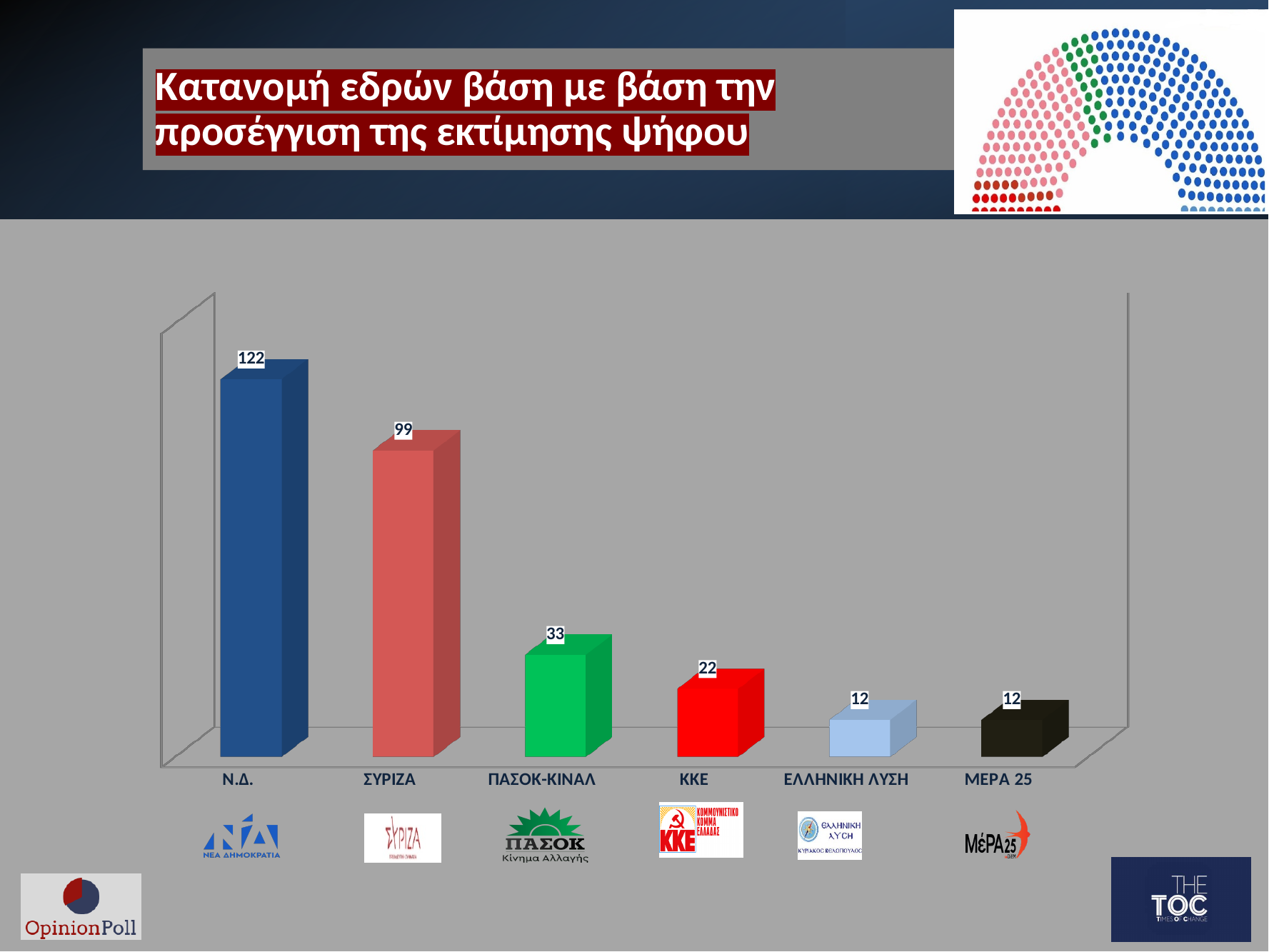
How many seats does the chart show for Ν.Δ.? 122 Which has more seats, ΣΥΡΙΖΑ or ΠΑΣΟΚ-ΚΙΝΑΛ? ΣΥΡΙΖΑ Which party has the highest number of seats in the chart? Ν.Δ. What kind of chart is shown on the slide? Bar chart What is the value shown for ΚΚΕ? 22 What is the difference in seats between ΠΑΣΟΚ-ΚΙΝΑΛ and ΚΚΕ? 11 What is the value shown for ΠΑΣΟΚ-ΚΙΝΑΛ? 33 How many parties (categories) are shown in the chart? 6 What is the value shown for ΣΥΡΙΖΑ? 99 What is the difference in seats between Ν.Δ. and ΣΥΡΙΖΑ? 23 What colour is the bar for ΠΑΣΟΚ-ΚΙΝΑΛ? Green What is the value shown for ΕΛΛΗΝΙΚΗ ΛΥΣΗ? 12